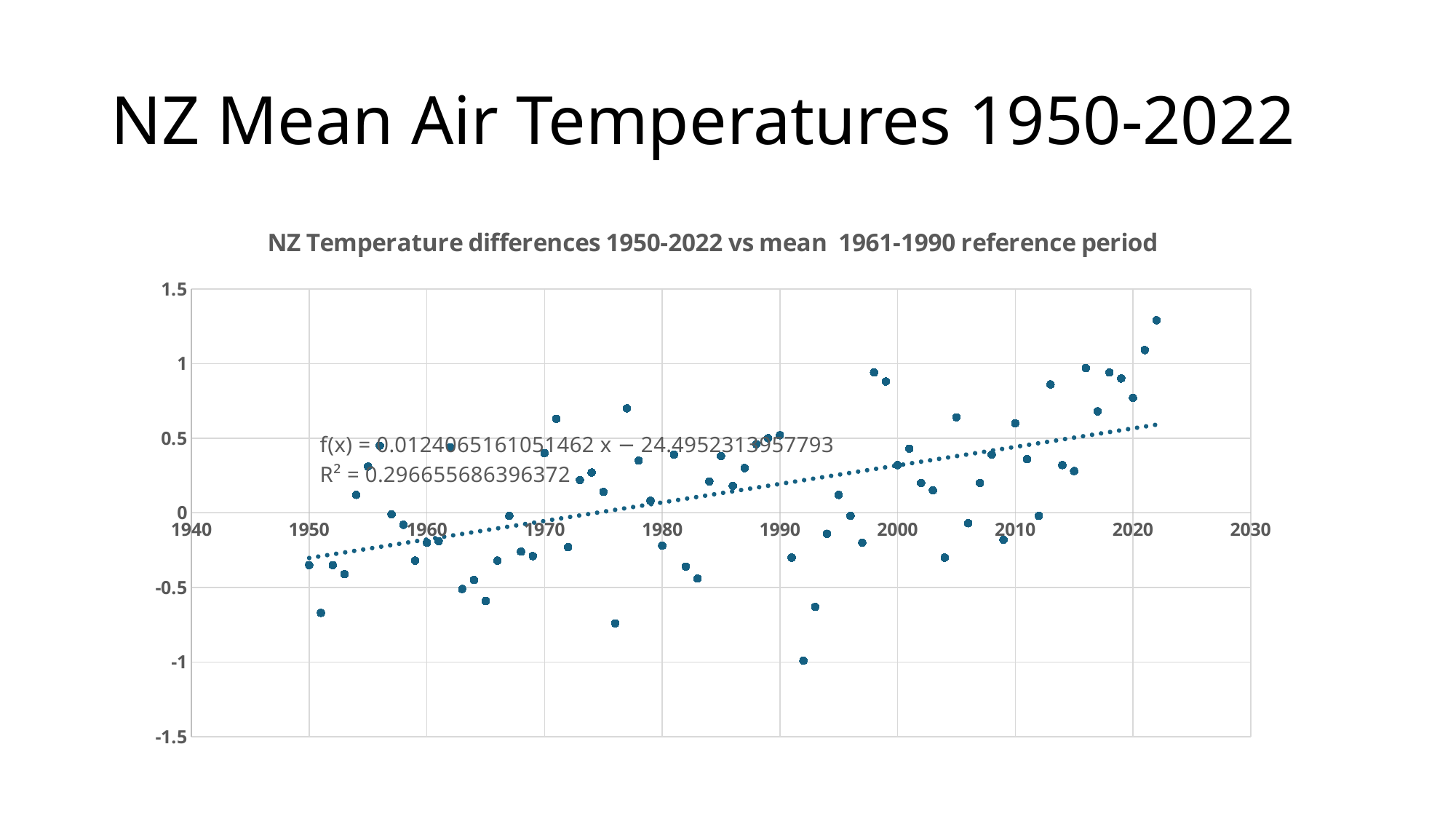
What is the minimum value shown on the y axis? -1.5 What is the maximum value shown on the y axis? 1.5 What is the R² value shown for the trendline? 0.296655686396372 Do the plotted temperature differences generally rise or fall from 1950 to 2022? rise Is the lowest plotted point on the chart greater or less than -0.5? less Which year has the highest temperature difference on the chart? 2022 What kind of chart is shown on the slide? scatter chart Is the value for the highest point (2022) greater or less than 1? greater Is the value for 1998 greater or less than 0.5? greater What is the slope of the trendline equation f(x) shown on the chart? 0.0124065161051462 What is the title of the chart? NZ Temperature differences 1950-2022 vs mean 1961-1990 reference period